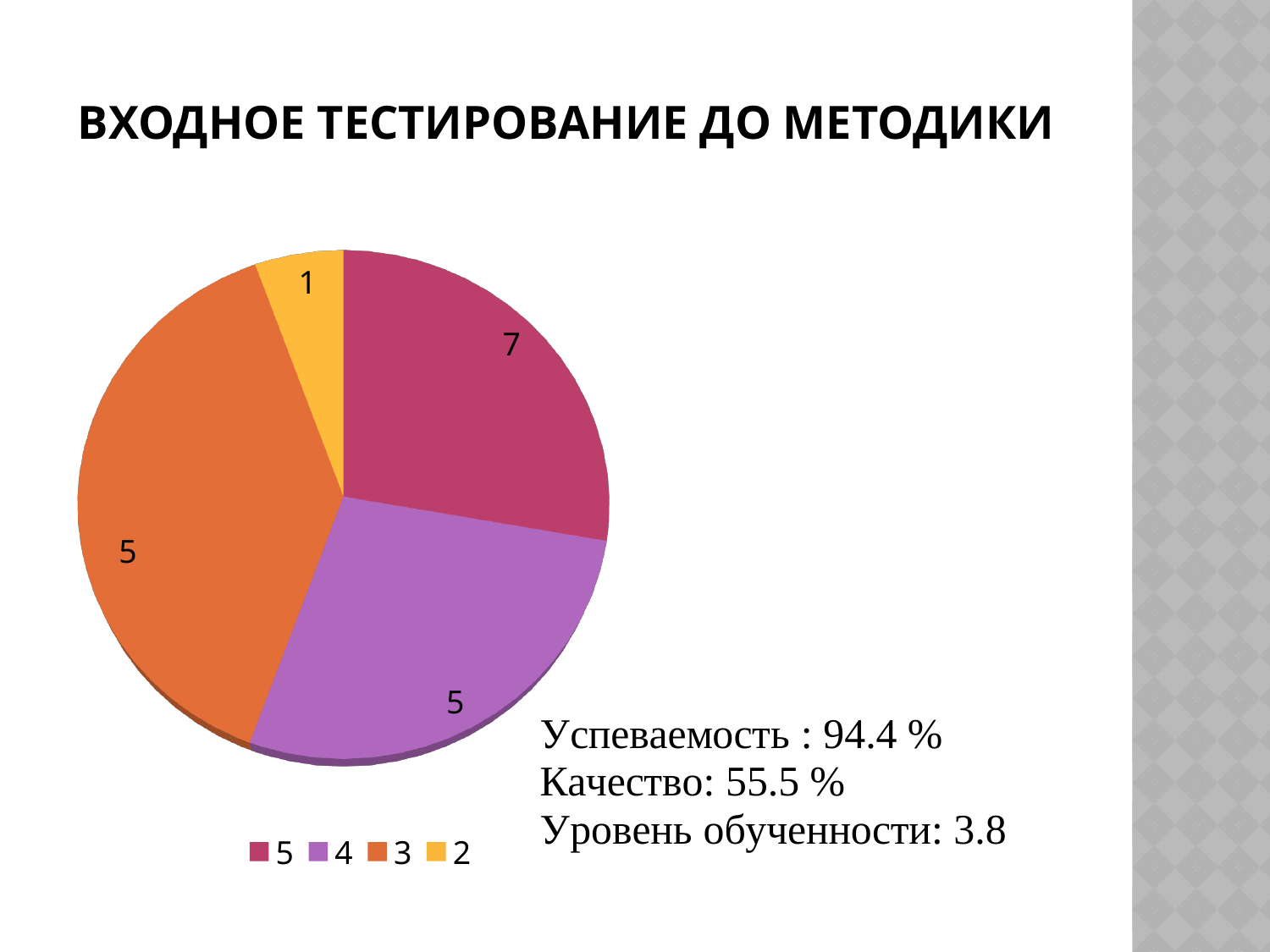
How many slices does the pie chart have? 4 What is the difference between the value for grade 5 and the value for grade 2? 6 What is the title of the slide containing the pie chart? ВХОДНОЕ ТЕСТИРОВАНИЕ ДО МЕТОДИКИ Which grade has the smallest slice in the pie chart? 2 What is the value of the slice for grade 3? 5 What type of chart is shown on the slide? pie chart What is the value of the slice for grade 5? 7 What is the value of the slice for grade 4? 5 What is the total of all slice values in the pie chart? 18 What is the value of the slice for grade 2? 1 Which is larger, the value for grade 5 or the value for grade 4? grade 5